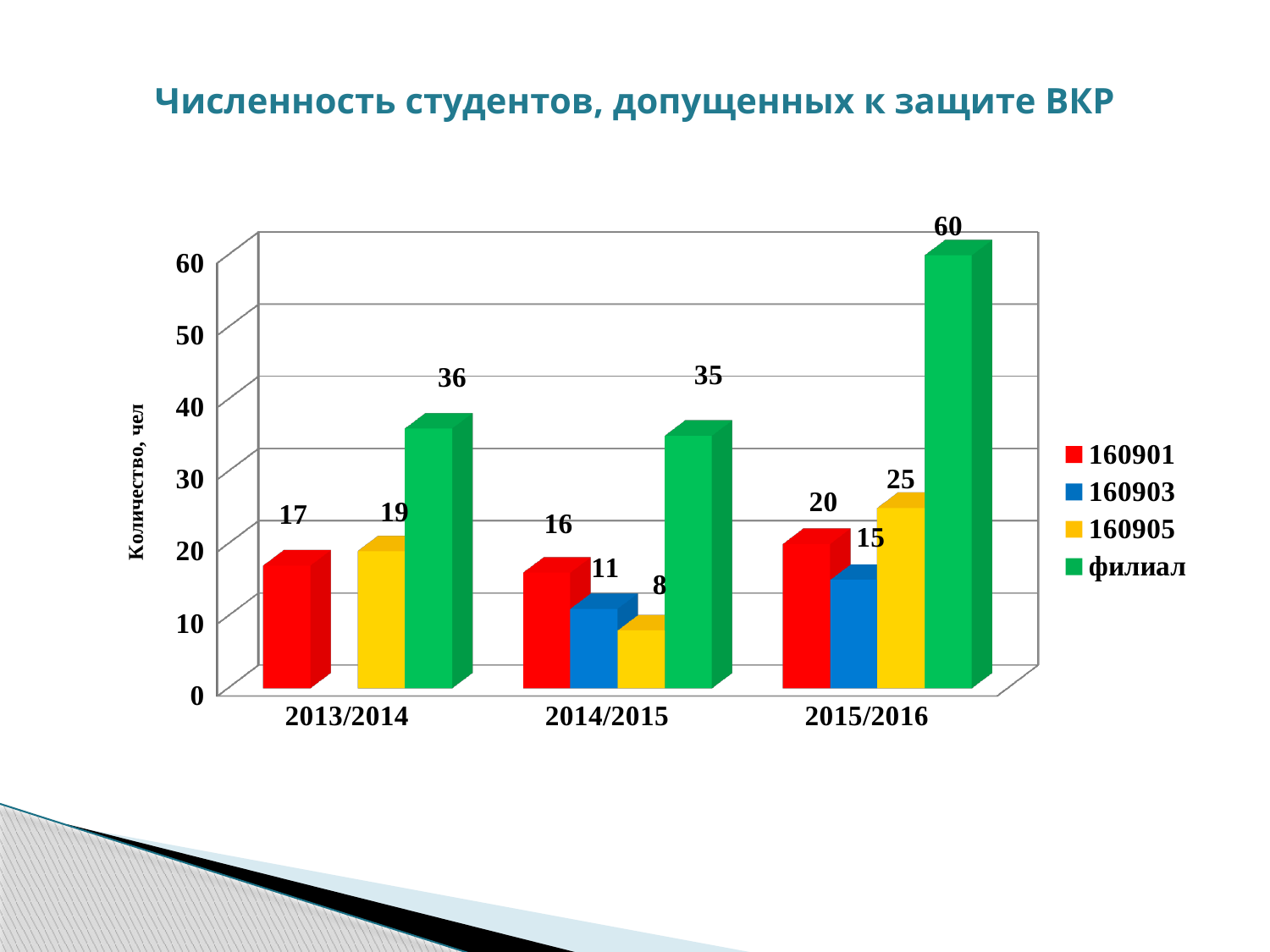
What is the label of the vertical axis? Количество, чел How many year categories are shown on the x axis? 3 What kind of chart is shown on the slide? bar chart How many series does the legend list? 4 In which year is the value for филиал highest? 2015/2016 Which is larger in 2015/2016: the value for 160901 or the value for 160905? 160905 In which year is the value for 160905 lowest? 2014/2015 What is the difference between the филиал values for 2015/2016 and 2014/2015? 25 What is the value for филиал in 2015/2016? 60 What is the value for 160905 in 2014/2015? 8 What is the value for 160903 in 2015/2016? 15 What is the value for 160901 in 2013/2014? 17